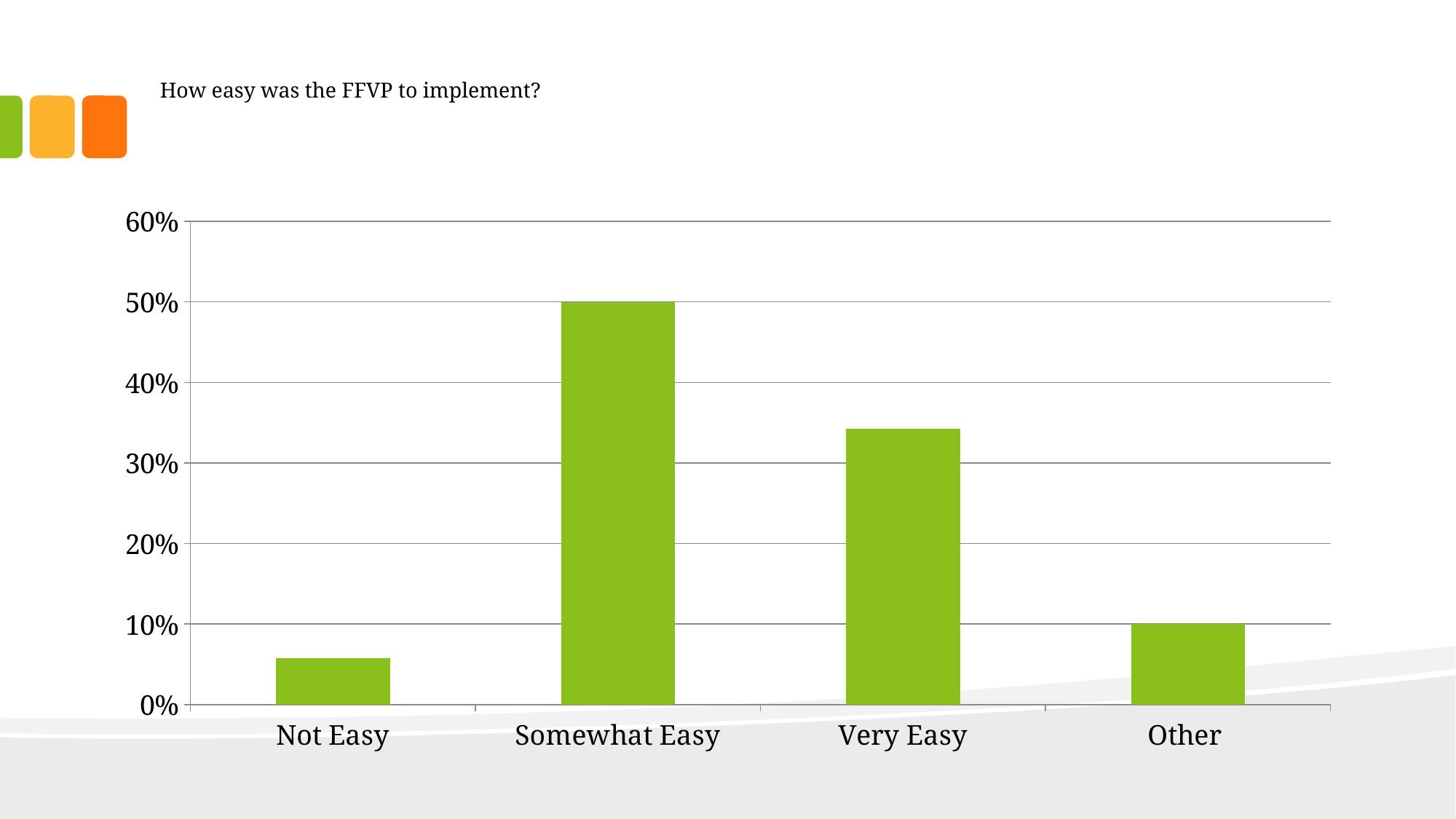
Which is larger, the value for Very Easy or the value for Other? Very Easy Which is larger, the value for Not Easy or the value for Other? Other Which category has the lowest value in the chart? Not Easy What kind of chart is shown on the slide? bar chart Which category has the highest value in the chart? Somewhat Easy Is the value for Very Easy greater or less than 40%? less What is the value for Other? 10% Is the value for Not Easy greater or less than 10%? less What is the value for Somewhat Easy? 50% Is the value for Very Easy greater or less than 30%? greater How many categories are shown on the x axis of the chart? 4 What is the difference between the values for Somewhat Easy and Other? 40%